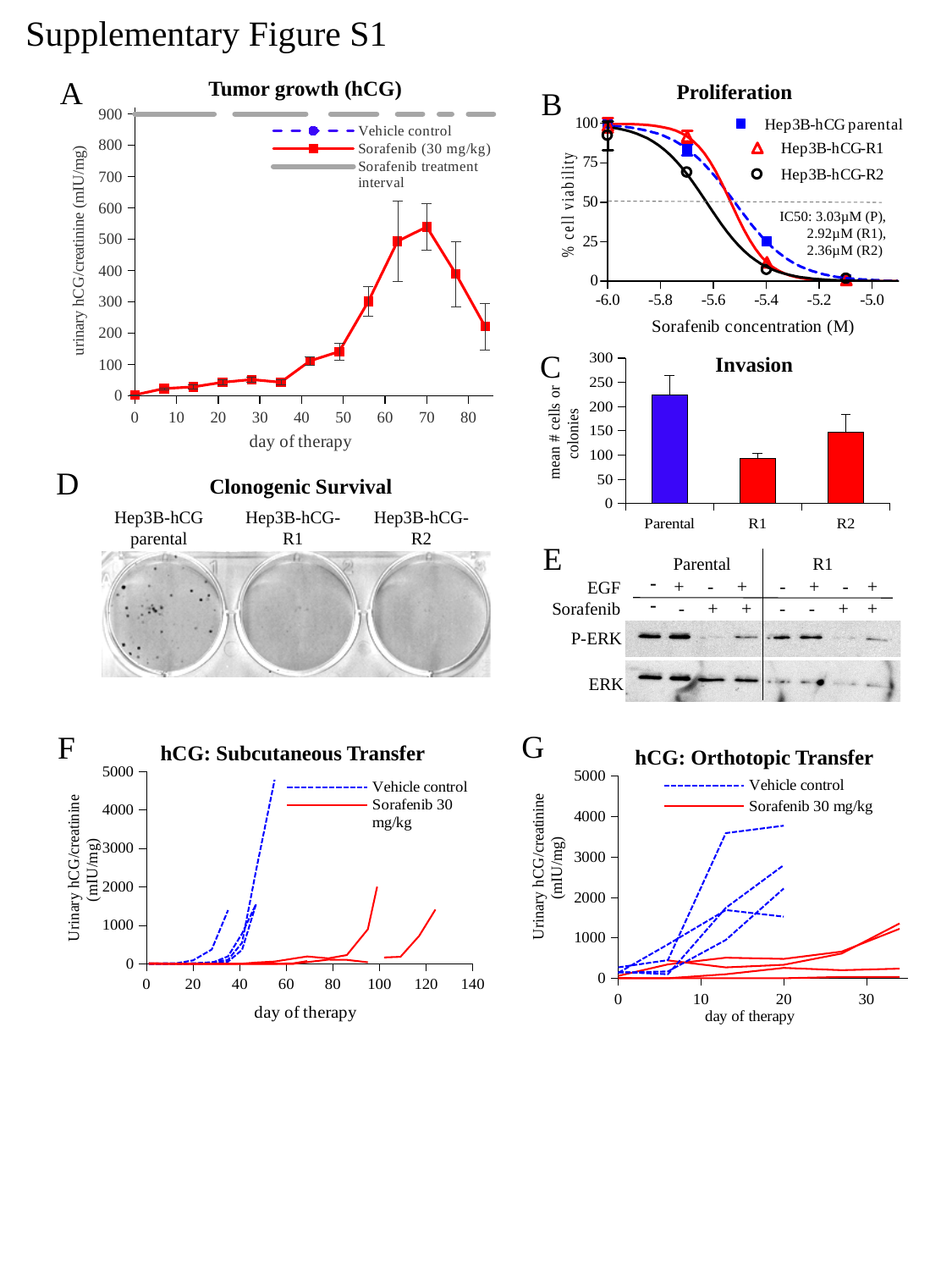
In the Invasion chart, is the value for Parental greater or less than 200? greater In the Invasion chart, which category has the highest mean number of cells or colonies? Parental How many series does the legend of the hCG: Subcutaneous Transfer chart list? 2 How many series does the legend of the Proliferation chart list? 3 In the Invasion chart, which is larger, the value for R2 or the value for R1? R2 In the Proliferation chart, what is the IC50 reported for the parental line (P)? 3.03µM In the Tumor growth (hCG) chart, is the Sorafenib value at day 70 greater or less than 500? greater What kind of chart is the hCG: Orthotopic Transfer chart? line chart How many categories are shown in the Invasion bar chart? 3 In the Invasion chart, which category has the lowest mean number of cells or colonies? R1 In the Invasion chart, is the value for R2 greater or less than 200? less In the Proliferation chart, what is the IC50 reported for Hep3B-hCG-R2? 2.36µM